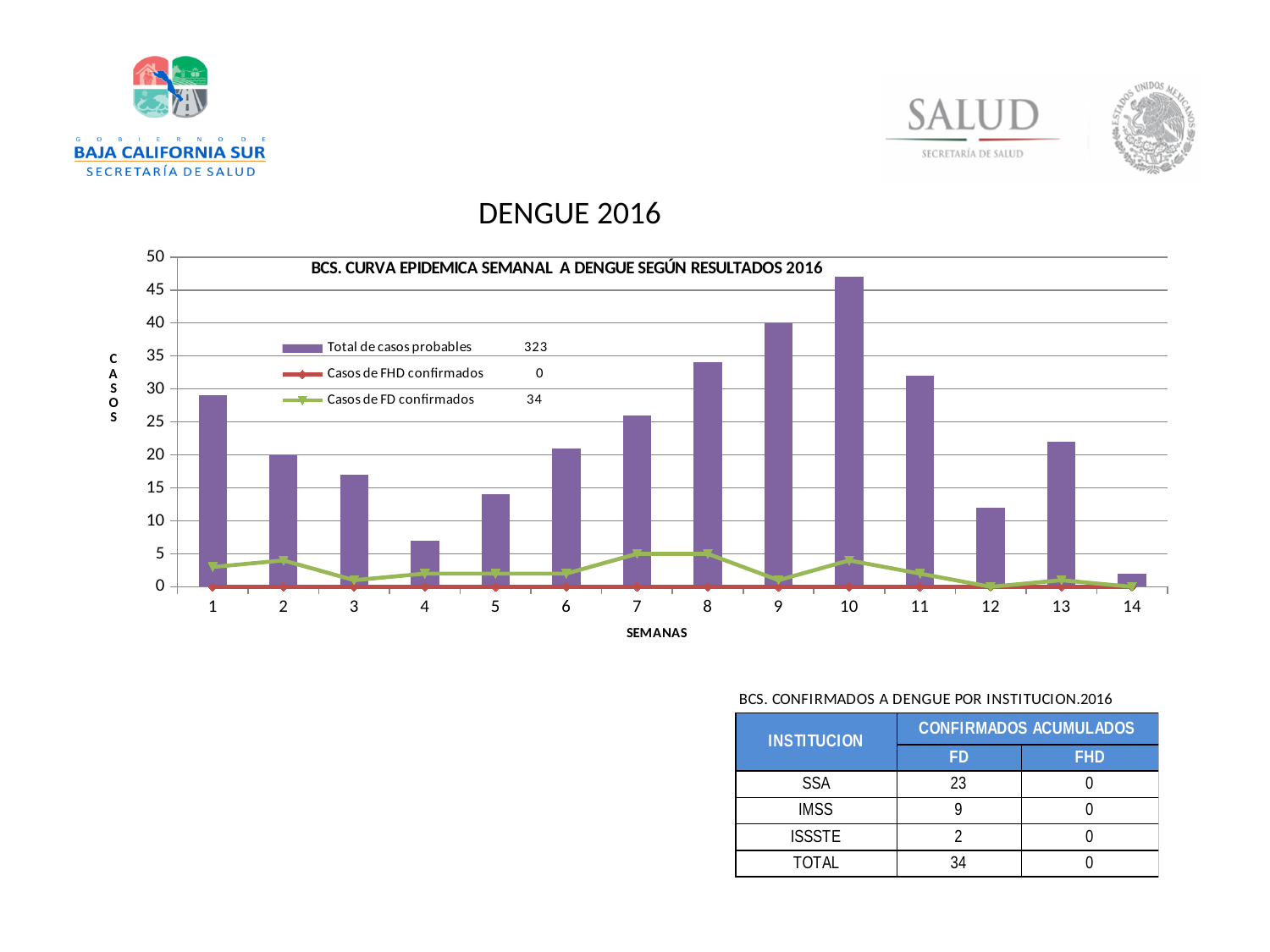
What kind of chart is used to show the weekly total of probable dengue cases? bar chart Do the Total de casos probables bars rise or fall from week 4 to week 10? rise Which week has a taller Total de casos probables bar, week 7 or week 9? week 9 Is the Total de casos probables bar for week 12 greater or less than 15? less Is the Total de casos probables bar for week 4 greater or less than 10? less What total is printed next to 'Total de casos probables' in the chart legend? 323 Is the Total de casos probables bar for week 1 greater or less than 25? greater In which week is the bar for Total de casos probables highest? 10 In which week is the bar for Total de casos probables lowest? 14 How many series does the chart legend list? 3 How many weeks (semanas) are shown on the x axis of the chart? 14